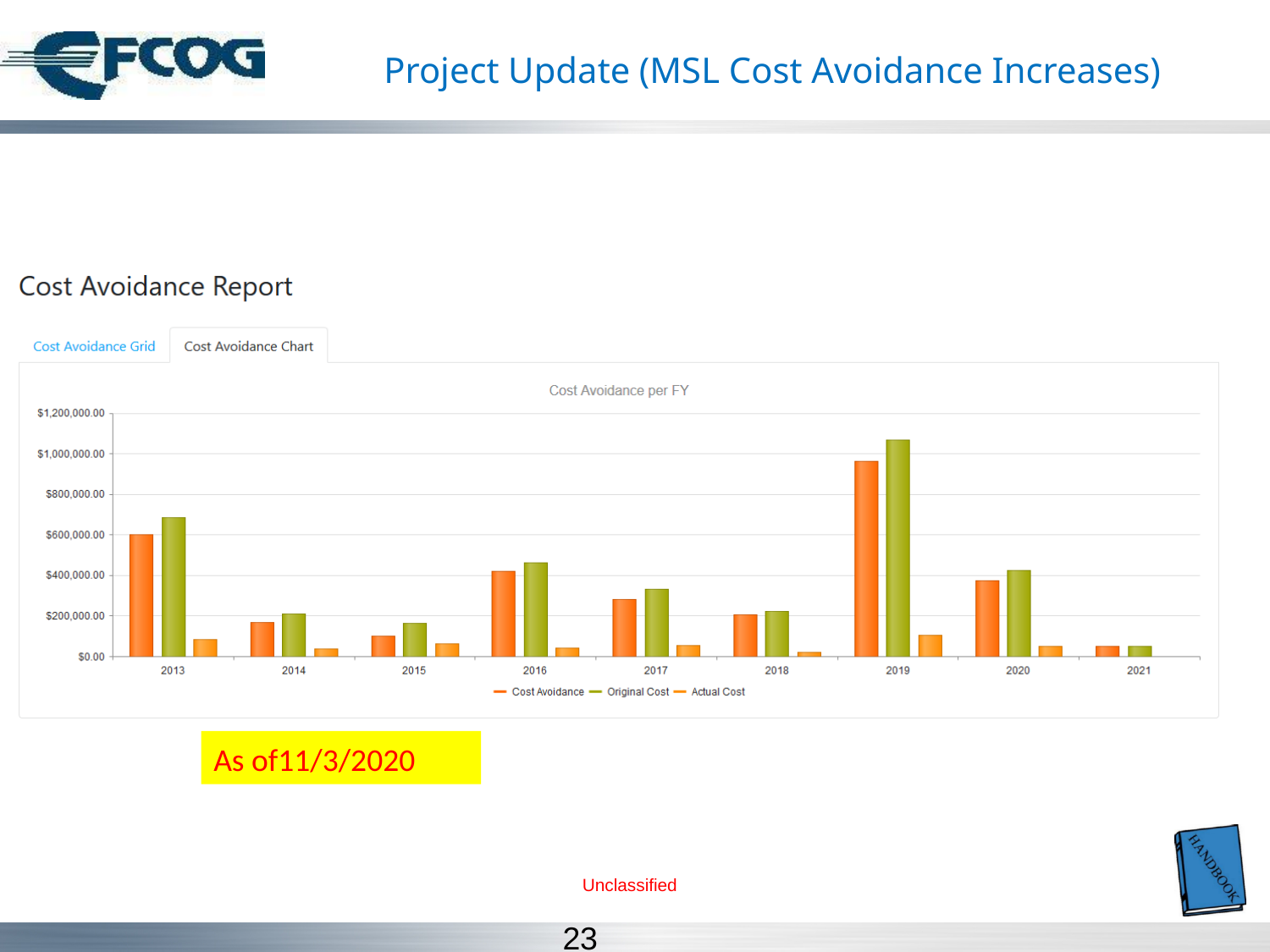
How many fiscal years are shown on the x axis of the chart? 9 Is the Actual Cost value for 2019 greater or less than $200,000.00? less Is the Cost Avoidance value for 2019 greater or less than $1,000,000.00? less What are the three series named in the chart legend? Cost Avoidance, Original Cost, Actual Cost What kind of chart is shown on the slide? Bar chart Is the Original Cost value for 2019 greater or less than $1,000,000.00? greater In which fiscal year is the Cost Avoidance bar the lowest? 2021 For 2019, which is larger: the Cost Avoidance bar or the Original Cost bar? Original Cost In which fiscal year is the Original Cost bar the highest? 2019 What is the title of the chart? Cost Avoidance per FY How many series does the chart legend list? 3